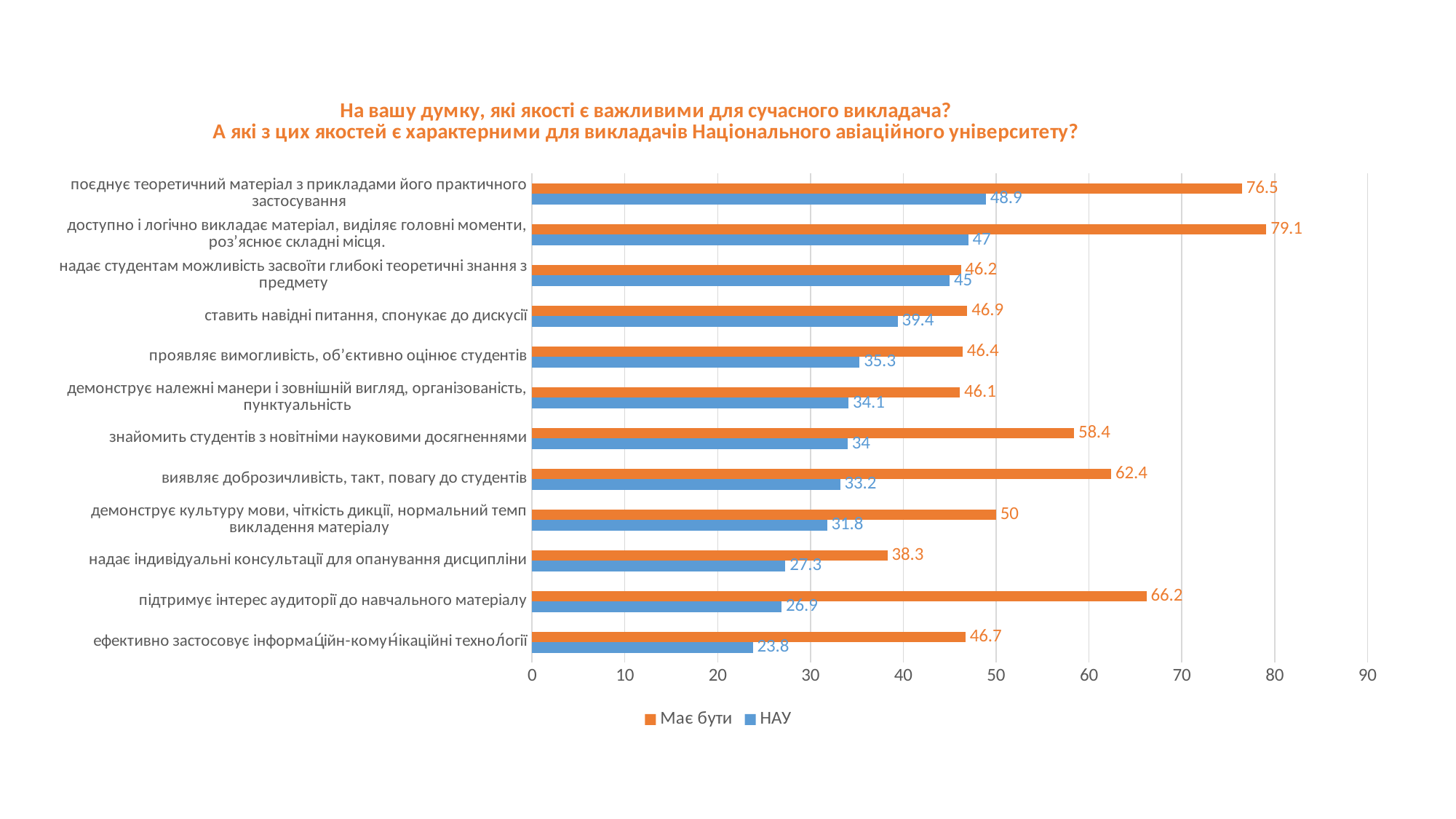
Which category has the lowest "Має бути" value? надає індивідуальні консультації для опанування дисципліни Which is larger for "знайомить студентів з новітніми науковими досягненнями": the "Має бути" value or the "НАУ" value? Має бути How many series does the legend list? 2 Which category has the highest "Має бути" value? доступно і логічно викладає матеріал, виділяє головні моменти, роз'яснює складні місця. What is the "Має бути" value for "підтримує інтерес аудиторії до навчального матеріалу"? 66.2 What is the "НАУ" value for "ставить навідні питання, спонукає до дискусії"? 39.4 Which series is shown in orange? Має бути What is the difference between the "Має бути" and "НАУ" values for "поєднує теоретичний матеріал з прикладами його практичного застосування"? 27.6 How many categories are plotted on the chart? 12 What type of chart is shown on the slide? bar chart Which category has the lowest "НАУ" value? ефективно застосовує інформаційн-комунікаційні технології What is the "НАУ" value for "ефективно застосовує інформаційн-комунікаційні технології"? 23.8